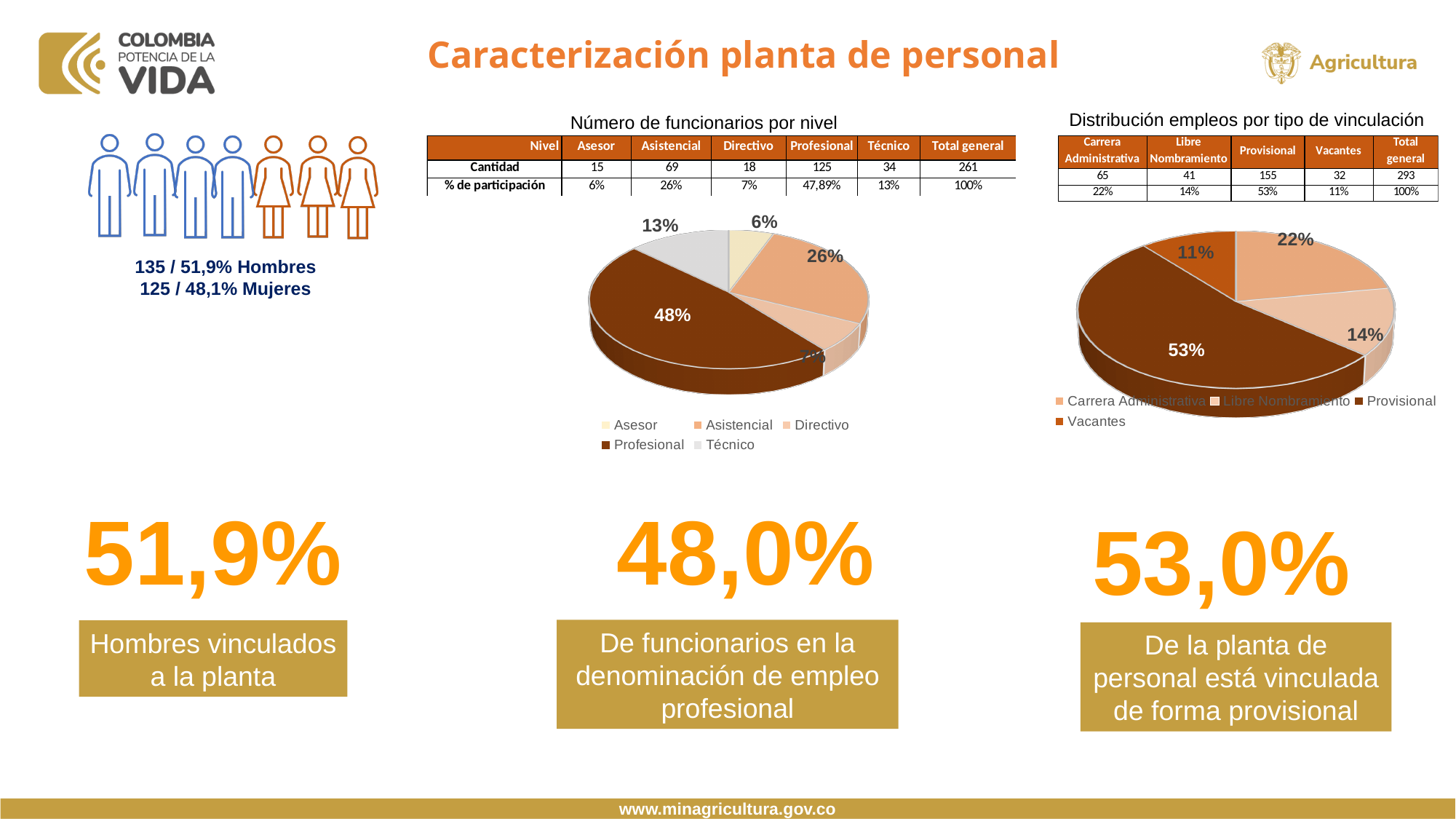
In the 'Número de funcionarios por nivel' chart, which category has the smallest slice? Asesor In the 'Número de funcionarios por nivel' chart, what share of the pie is Técnico? 13% What kind of chart is 'Distribución empleos por tipo de vinculación'? Pie chart In the 'Número de funcionarios por nivel' chart, what share of the pie is Profesional? 48% In the 'Distribución empleos por tipo de vinculación' chart, which category has the smallest slice? Vacantes In the 'Número de funcionarios por nivel' chart, what share of the pie is Asistencial? 26% In the 'Número de funcionarios por nivel' chart, which category has the largest slice? Profesional In the 'Distribución empleos por tipo de vinculación' chart, what is the difference in percentage points between Provisional and Libre Nombramiento? 39 percentage points In the 'Distribución empleos por tipo de vinculación' chart, which is larger, Carrera Administrativa or Libre Nombramiento? Carrera Administrativa In the 'Número de funcionarios por nivel' chart, how many categories does the legend list? 5